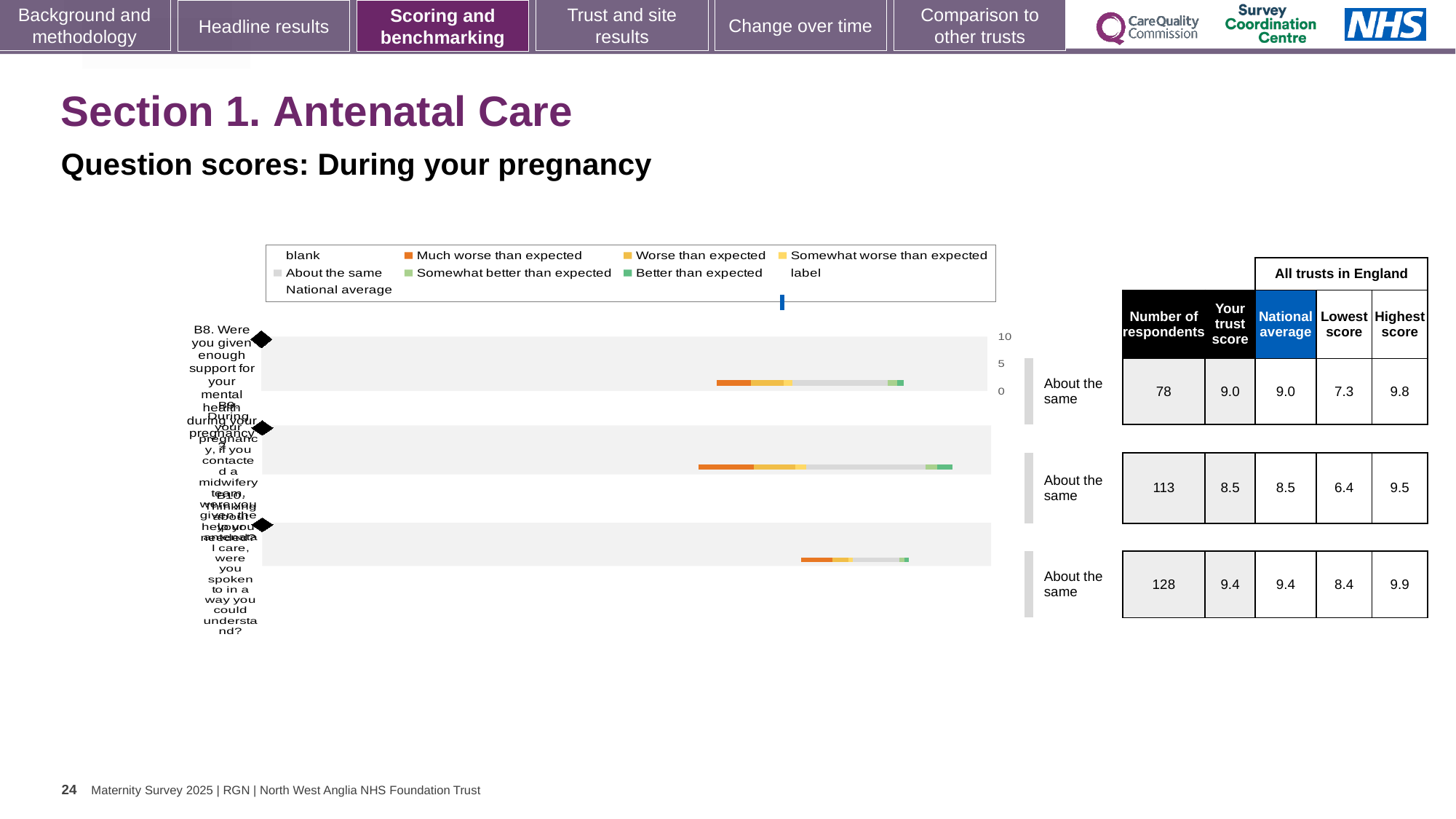
How many question rows (bars) are plotted in the chart? 3 What is the number of respondents for the first question row (B8, support for your mental health)? 78 What is the benchmark category shown for each of the three questions in the chart? About the same What is the lowest score among all trusts in England for the second question row? 6.4 What is the national average for the third question row? 9.4 What kind of chart is shown on the slide? bar chart What is the difference between the highest score and the lowest score for the first question row? 2.5 Is the lowest score for the first question row larger or smaller than the lowest score for the second question row? larger Which question row has the fewest respondents? the first row (78) What is the highest score among all trusts in England for the third question row? 9.9 What is the trust score for the second question row? 8.5 Which question row has the highest trust score? the third row (9.4)